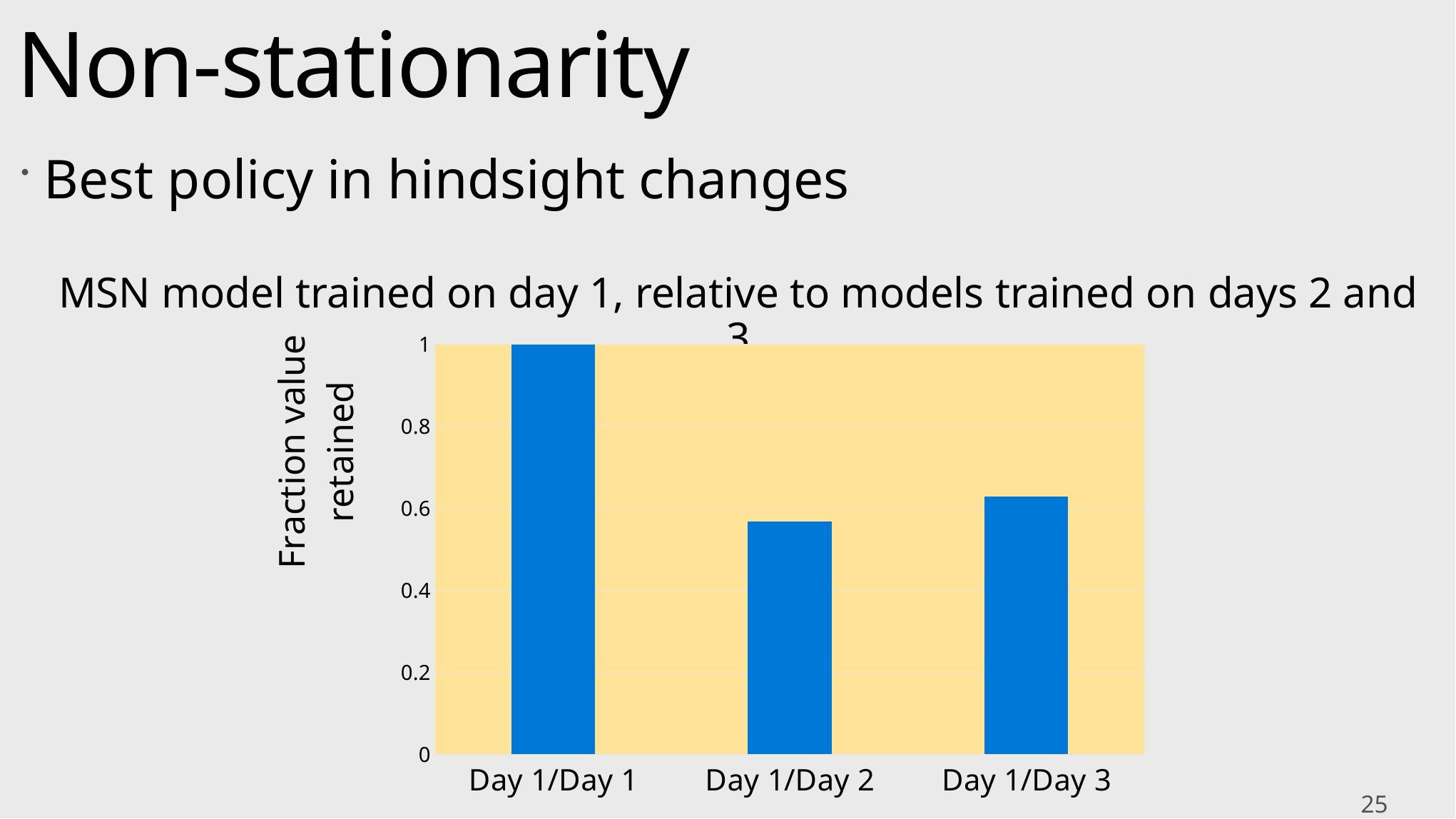
What is the title of the chart? MSN model trained on day 1, relative to models trained on days 2 and 3 Is the value for Day 1/Day 3 greater or less than 0.6? greater Is the value for Day 1/Day 2 greater or less than 0.4? greater What is the label on the vertical axis of the chart? Fraction value retained What kind of chart is shown on the slide? Bar chart Is the value for Day 1/Day 3 greater or less than 0.8? less Which category has the lowest fraction value retained? Day 1/Day 2 Which category has the highest fraction value retained? Day 1/Day 1 How many bars (categories) does the chart show? 3 What is the fraction value retained for Day 1/Day 1? 1 Which is larger, the value for Day 1/Day 2 or the value for Day 1/Day 3? Day 1/Day 3